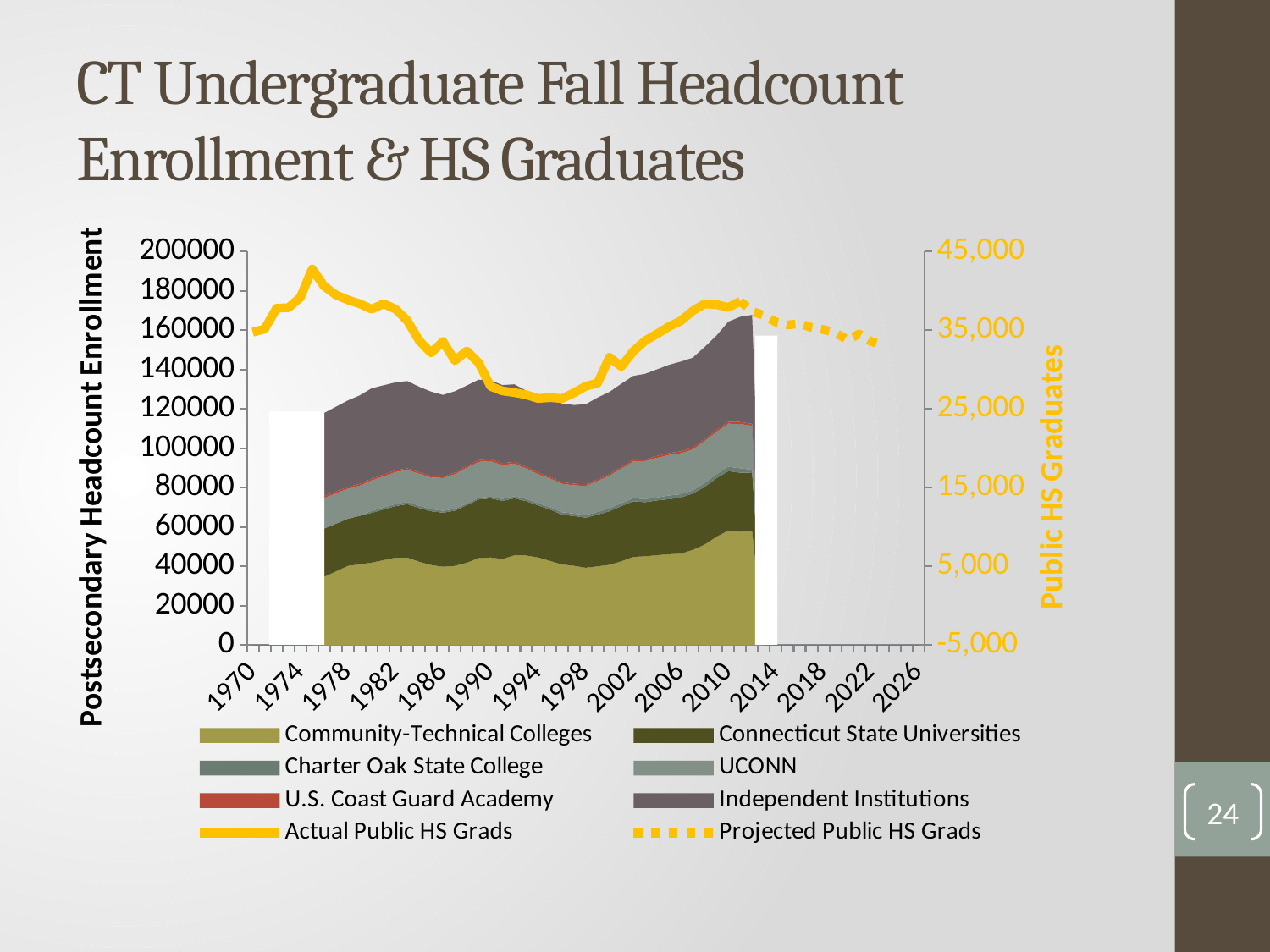
What is the title of the chart on the slide? CT Undergraduate Fall Headcount Enrollment & HS Graduates Is the value for Projected Public HS Grads in 2022 greater or less than 25,000? greater Is the value for Actual Public HS Grads around 1976 greater or less than 35,000? greater Is the total stacked postsecondary enrollment in 1978 greater or less than 140000? less What kind of chart is shown on the slide? Stacked area chart with line overlay Which is larger, the Actual Public HS Grads value around 1976 or around 1996? 1976 How many series does the legend list? 8 Do the Projected Public HS Grads values rise or fall from 2014 to 2022? fall Do the Actual Public HS Grads values rise or fall from 1996 to 2010? rise What is the title of the right-hand vertical axis? Public HS Graduates